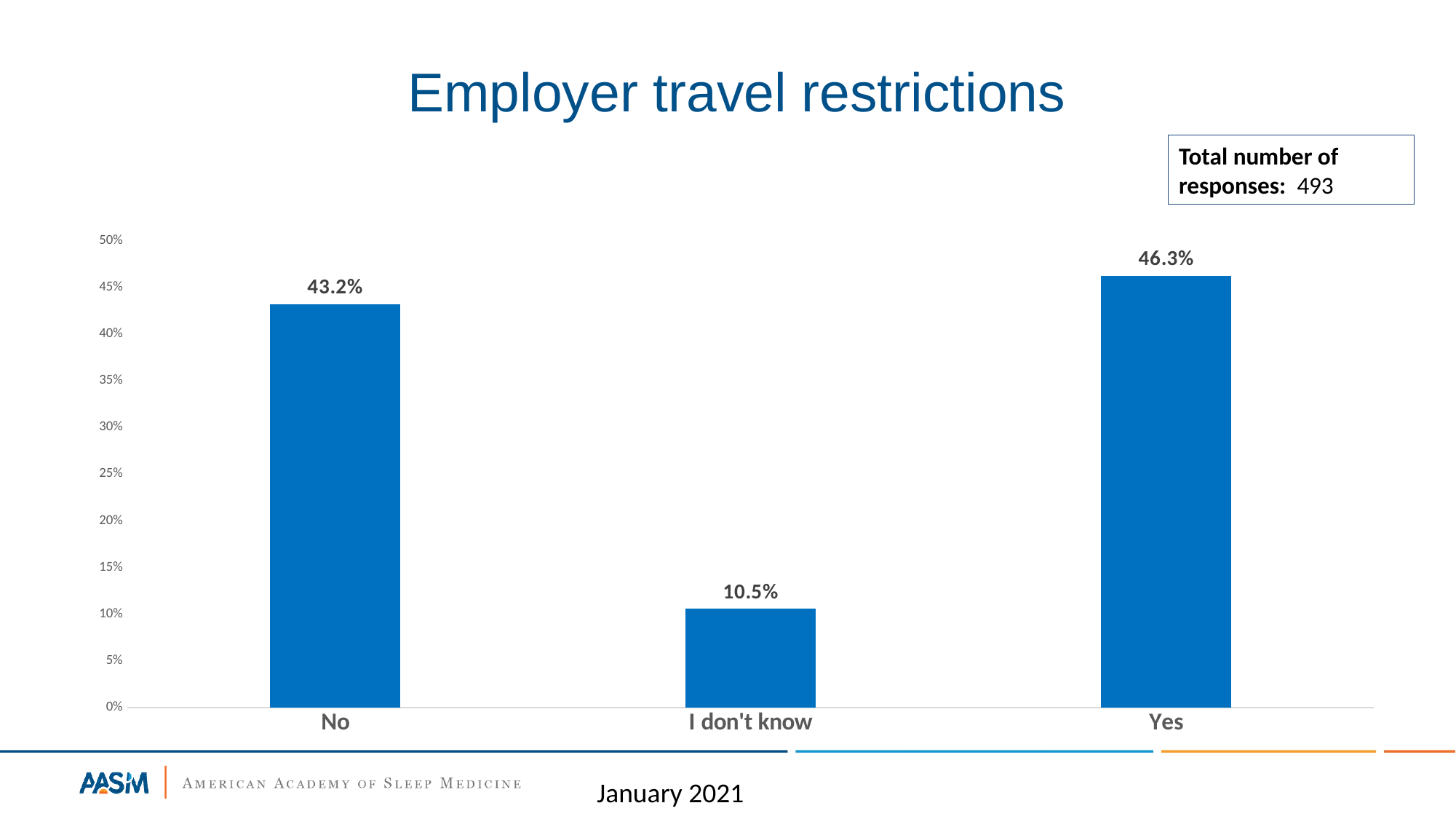
What kind of chart is shown on the slide? bar chart Is the value for "Yes" greater or less than 45%? greater What is the difference between the values for "No" and "I don't know"? 32.7% What is the difference between the values for "Yes" and "No"? 3.1% Which category has the lowest value? I don't know How many categories are shown on the x axis? 3 Which category has the highest value? Yes Which is larger, the value for "No" or the value for "I don't know"? No What is the value for "Yes"? 46.3% What is the value for "No"? 43.2% What is the title of the chart? Employer travel restrictions What is the value for "I don't know"? 10.5%